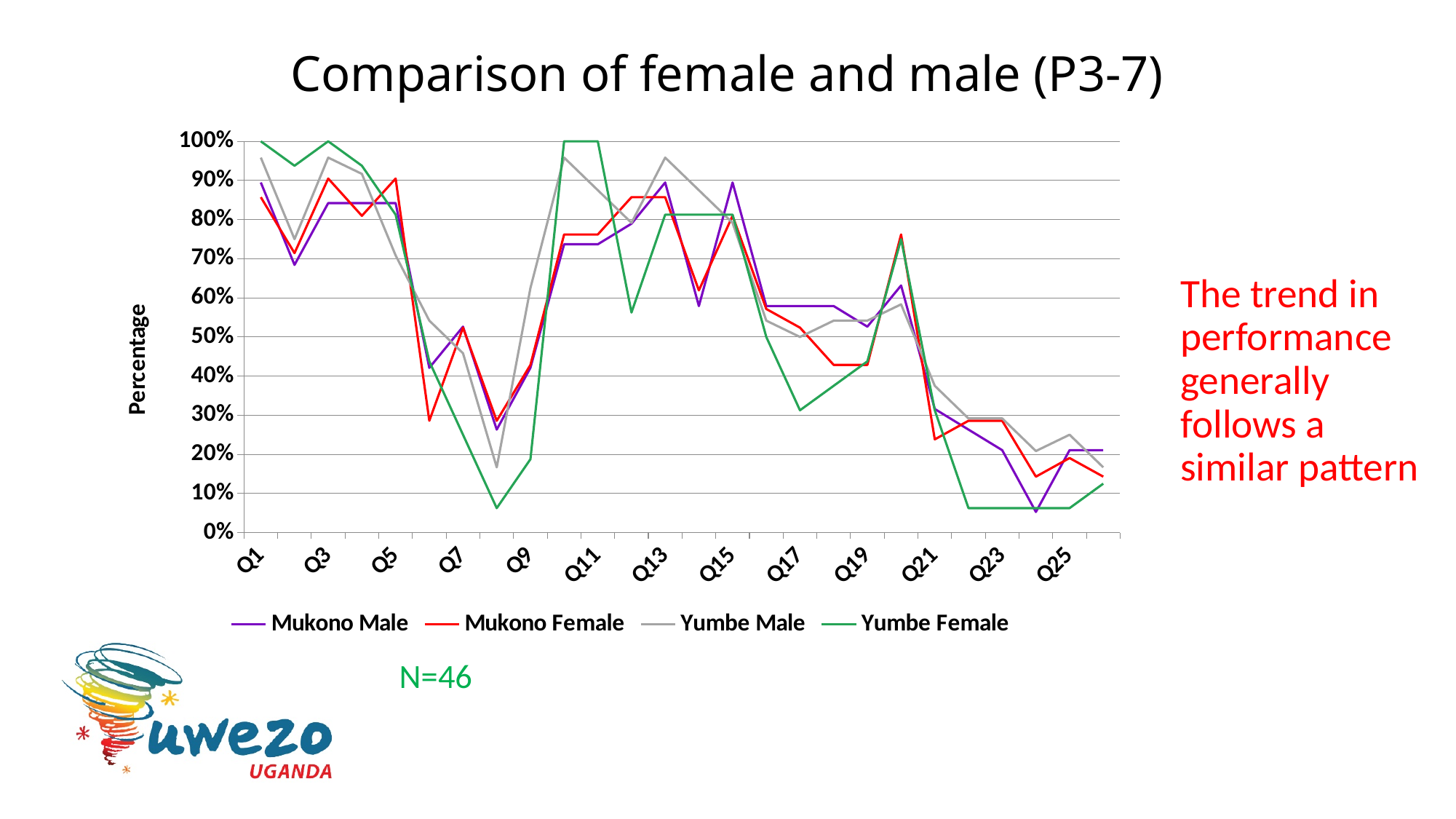
What is the value for Yumbe Female at Q3? 100% How many series does the legend list? 4 Overall, do the values rise or fall from Q1 to the last question on the x axis? fall Which series has the lowest value at Q8? Yumbe Female What is the title of the y axis? Percentage Which series has the highest value at Q1? Yumbe Female What kind of chart is shown on the slide? line chart At Q17, which is larger: Mukono Male or Yumbe Female? Mukono Male What is the value for Yumbe Female at Q1? 100% Is the value for Mukono Male at Q1 greater or less than 80%? greater Is the value for Mukono Male at Q24 greater or less than 10%? less Is the value for Yumbe Male at Q8 greater or less than 20%? less